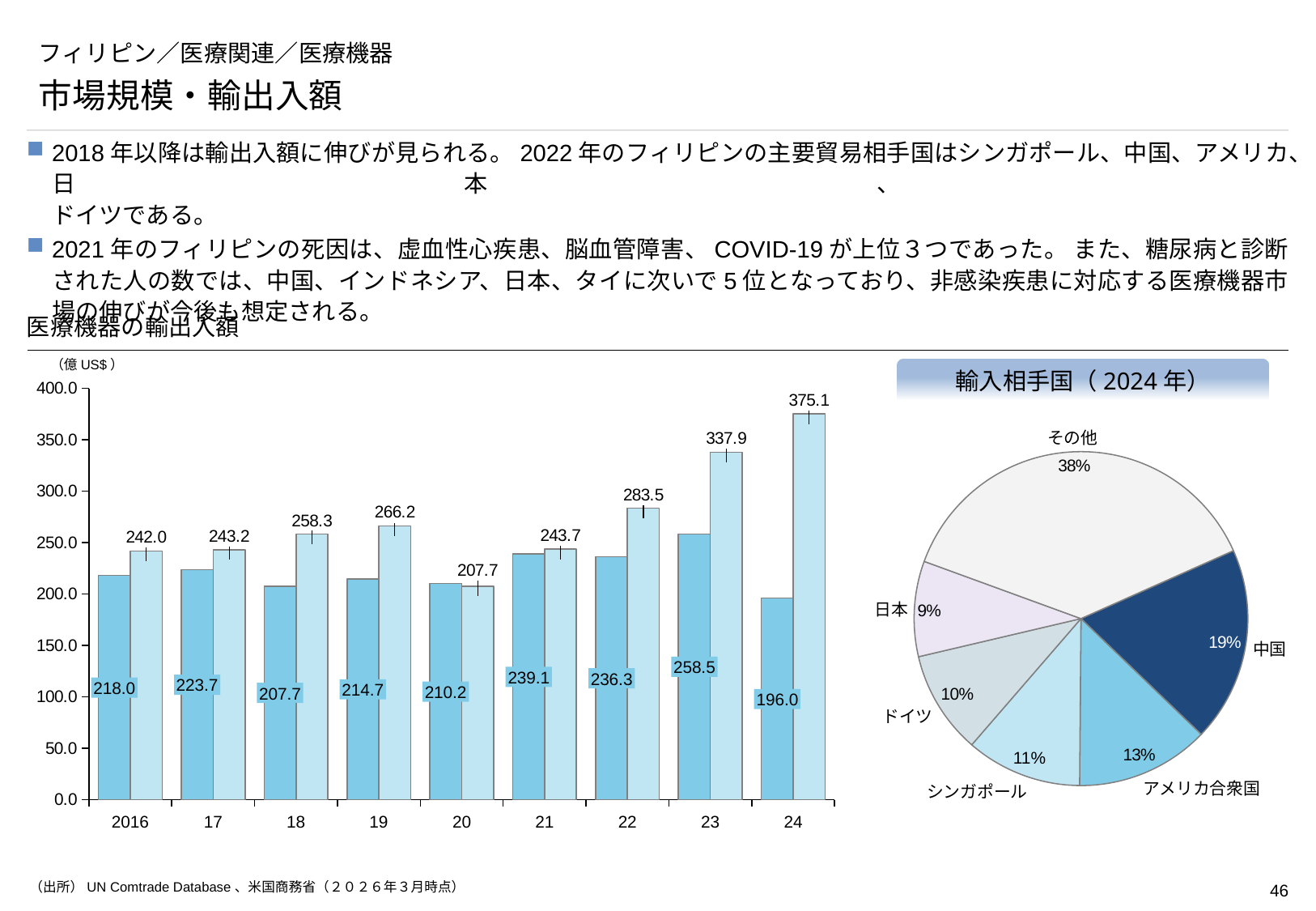
In the bar chart 医療機器の輸出入額, which year has the lowest value for the lighter bar? 20 In the pie chart 輸入相手国（2024年）, how many slices are there? 6 What kind of chart is 医療機器の輸出入額? bar chart In the bar chart 医療機器の輸出入額, how many years are shown on the x axis? 9 In the bar chart 医療機器の輸出入額, what is the value of the darker bar for 2016? 218.0 In the pie chart 輸入相手国（2024年）, what share does 中国 have? 19% In the bar chart 医療機器の輸出入額, what is the value of the darker bar for 23? 258.5 In the pie chart 輸入相手国（2024年）, which is larger, the share of シンガポール or the share of ドイツ? シンガポール In the bar chart 医療機器の輸出入額, what is the value of the lighter bar for 24? 375.1 In the bar chart 医療機器の輸出入額, what is the difference between the lighter bar and the darker bar for 24? 179.1 In the pie chart 輸入相手国（2024年）, which named country has the smallest share? 日本 In the bar chart 医療機器の輸出入額, which year has the lowest value for the darker bar? 24